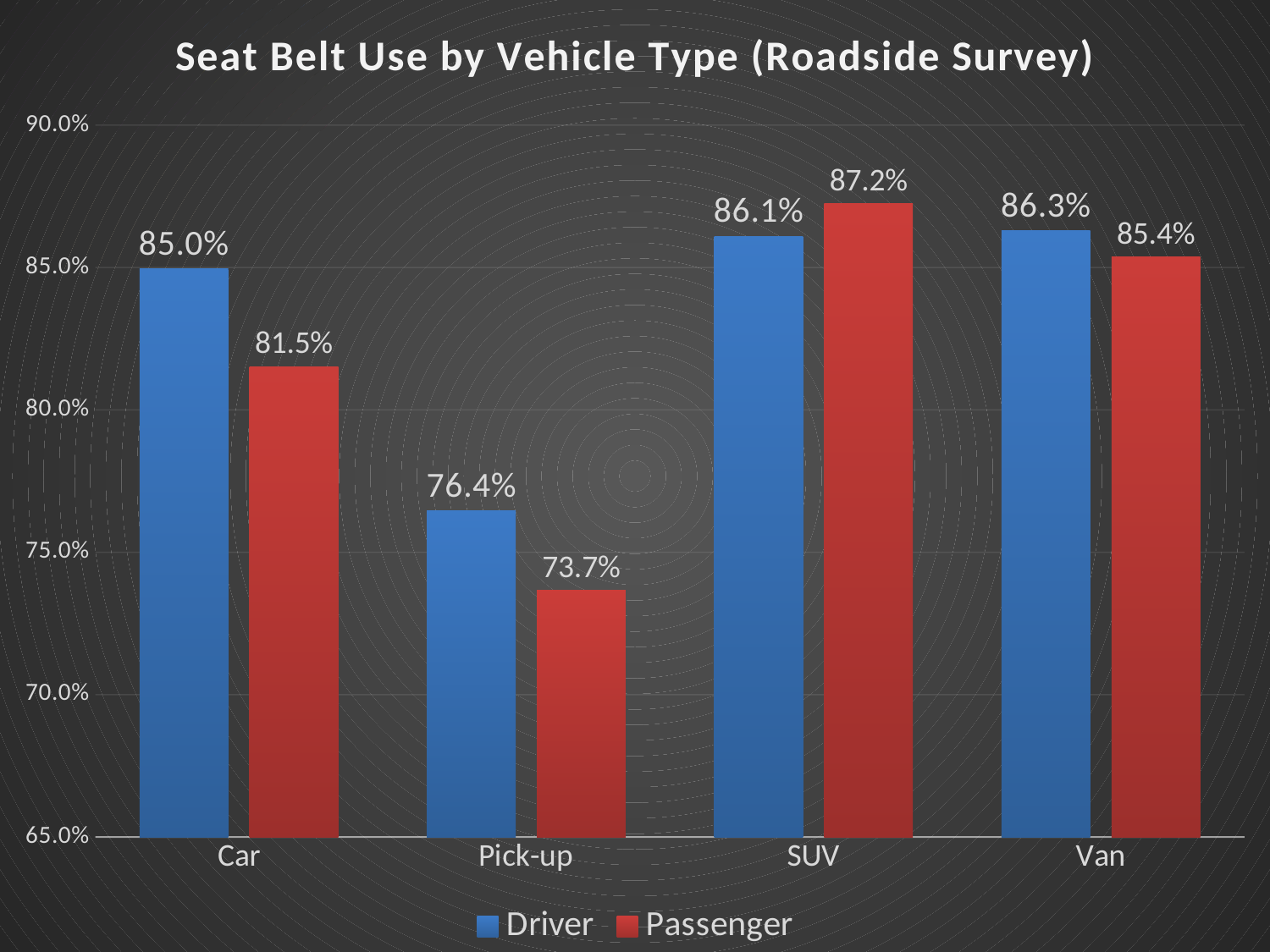
Which vehicle type has the highest Driver seat belt use rate? Van How many vehicle types are shown on the x axis? 4 What kind of chart is shown on the slide? Bar chart What is the difference between the Passenger seat belt use rates for SUV and Pick-up? 13.5% Which vehicle type has the lowest Passenger seat belt use rate? Pick-up What is the Passenger seat belt use rate for Pick-up? 73.7% What is the difference between the Driver and Passenger seat belt use rates for Car? 3.5% How many series does the legend list? 2 Which is larger for SUV, the Driver rate or the Passenger rate? Passenger What is the Passenger seat belt use rate for SUV? 87.2% Is the Driver seat belt use rate for Pick-up greater or less than 80.0%? less What is the Driver seat belt use rate for Car? 85.0%